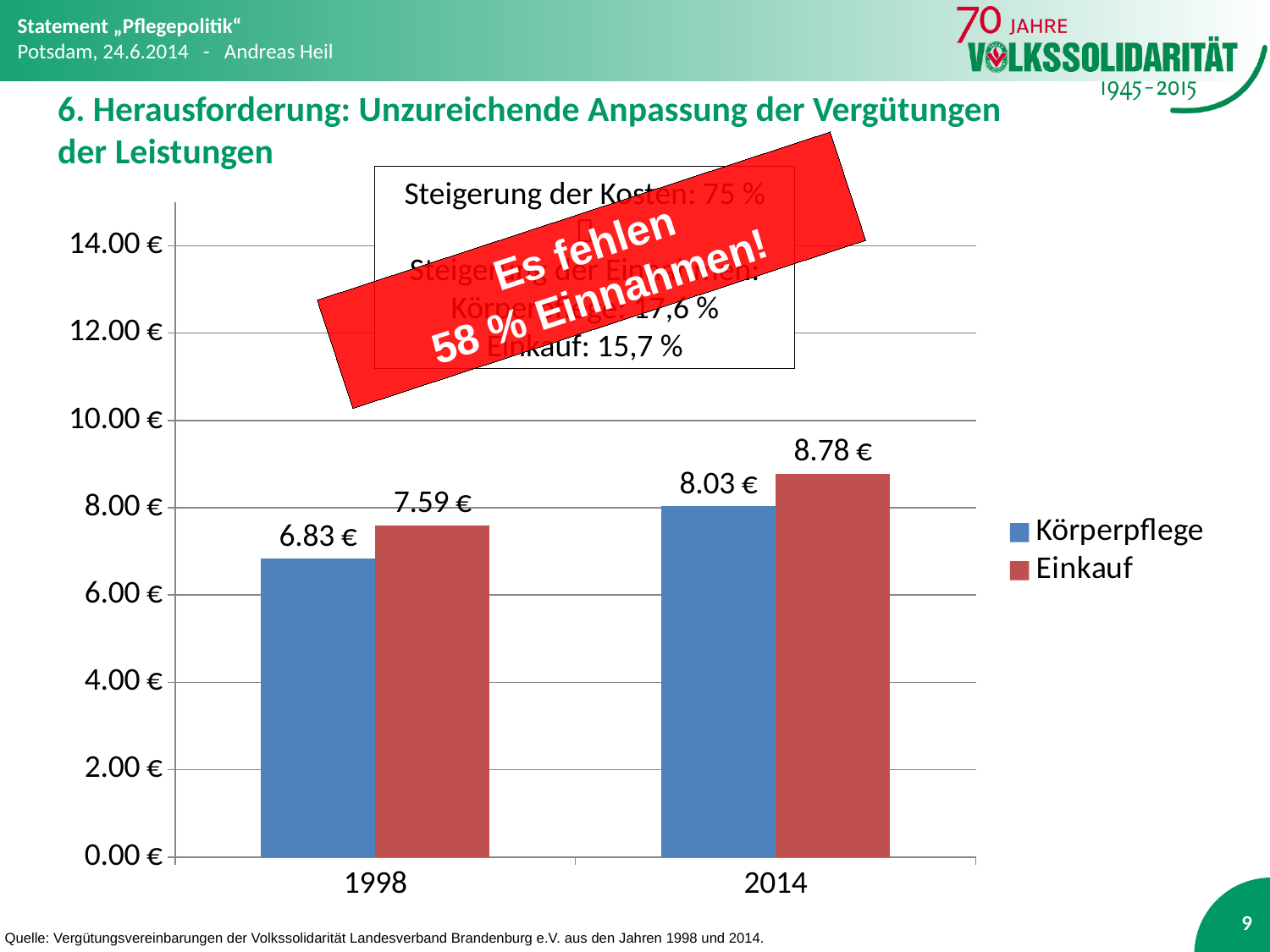
Do the values for Körperpflege rise or fall from 1998 to 2014? Rise Which is larger in 2014, Körperpflege or Einkauf? Einkauf What kind of chart is shown on the slide? Bar chart What is the difference between Einkauf and Körperpflege in 1998? 0.76 € What is the value for Einkauf in 2014? 8.78 € How many series does the legend list? 2 Which bar has the lowest value in the chart? Körperpflege in 1998 What is the value for Einkauf in 1998? 7.59 € What is the value for Körperpflege in 2014? 8.03 € What is the value for Körperpflege in 1998? 6.83 € By how much did the value for Einkauf increase from 1998 to 2014? 1.19 € Which bar has the highest value in the chart? Einkauf in 2014